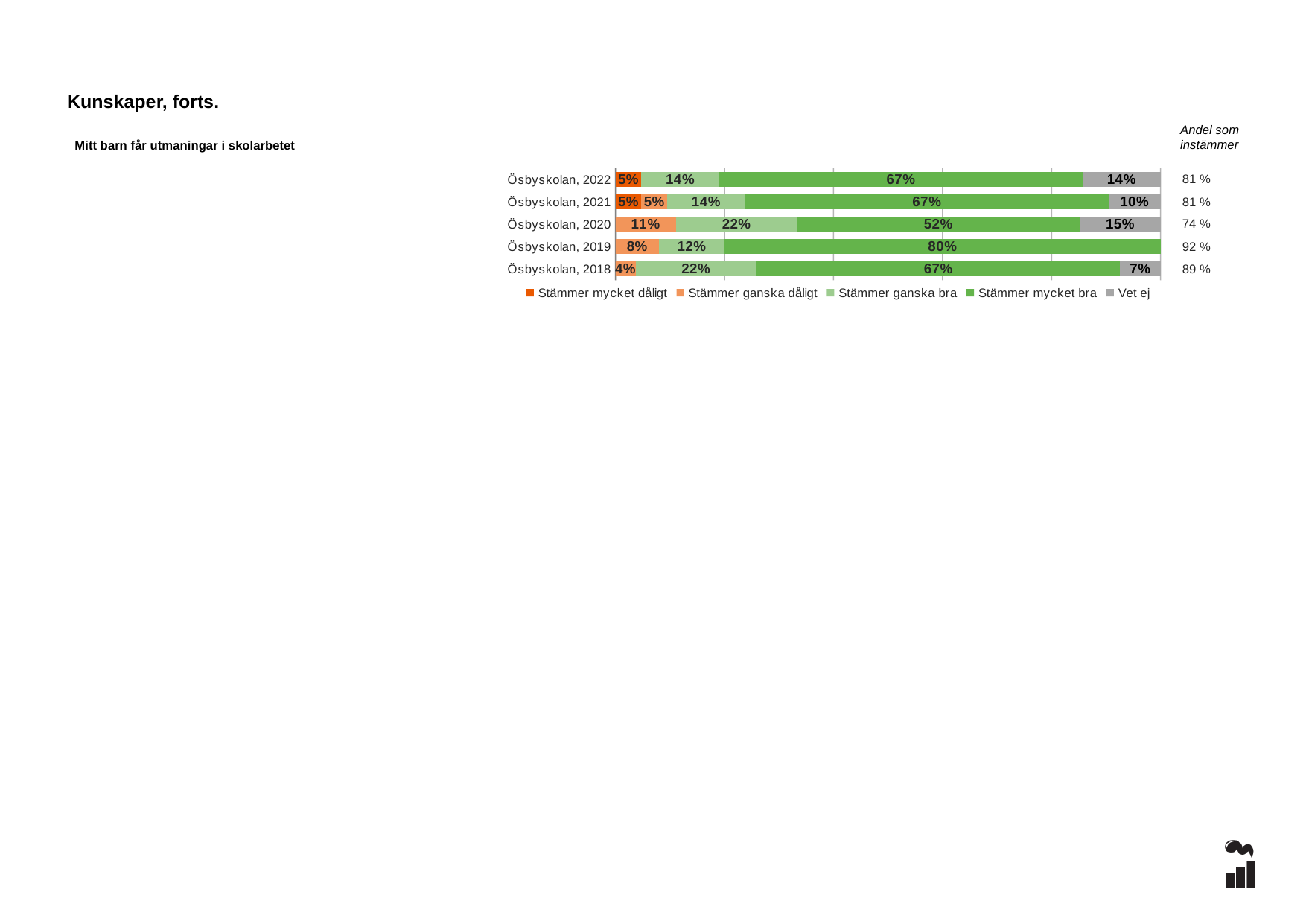
What kind of chart is shown on the slide? Stacked bar chart What is the "Andel som instämmer" figure shown for Ösbyskolan, 2020? 74 % What percentage of respondents answered "Stämmer mycket bra" for Ösbyskolan, 2019? 80% What is the difference in percentage points between the "Stämmer mycket bra" values for Ösbyskolan, 2019 and Ösbyskolan, 2020? 28 percentage points Which year has the lowest "Stämmer mycket bra" value? Ösbyskolan, 2020 How many categories (bars) are shown in the chart? 5 What statement is the chart about, according to the label above it? Mitt barn får utmaningar i skolarbetet What is the "Stämmer ganska bra" value for Ösbyskolan, 2018? 22% How many series does the legend list? 5 Which year has the highest "Stämmer mycket bra" value? Ösbyskolan, 2019 What is the "Vet ej" value for Ösbyskolan, 2020? 15% Which is larger: the "Stämmer ganska dåligt" value for Ösbyskolan, 2020 or for Ösbyskolan, 2018? Ösbyskolan, 2020